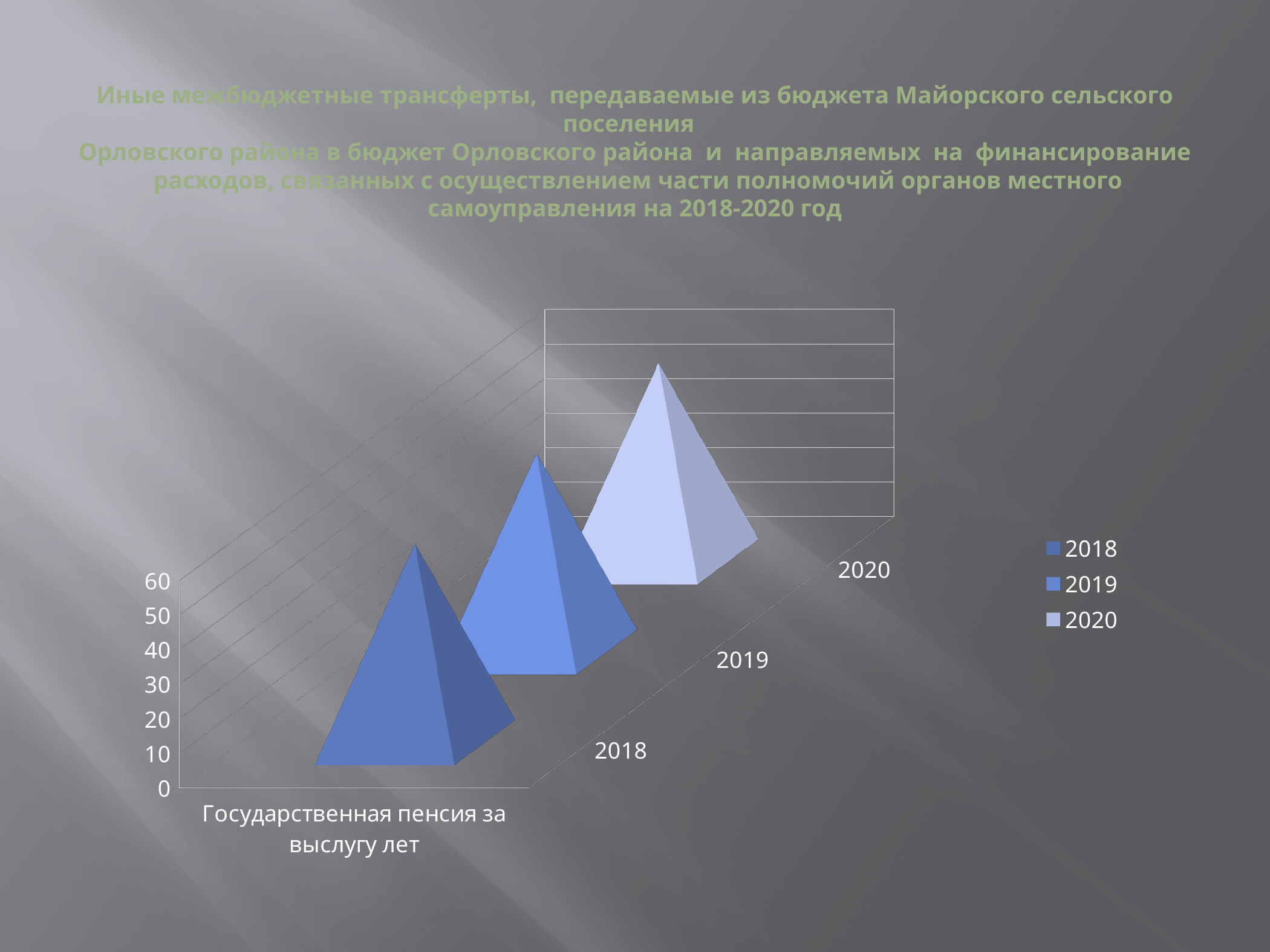
What kind of chart is shown on the slide? bar chart Which years are listed in the chart legend? 2018, 2019, 2020 Is the value for 2018 for Государственная пенсия за выслугу лет greater or less than 20? greater Is the value for 2020 for Государственная пенсия за выслугу лет greater or less than 20? greater How many series does the legend list? 3 What is the name of the category shown on the x axis? Государственная пенсия за выслугу лет How many categories are shown on the x axis of the chart? 1 Is the value for 2019 for Государственная пенсия за выслугу лет greater or less than 20? greater What is the highest value shown on the vertical axis of the chart? 60